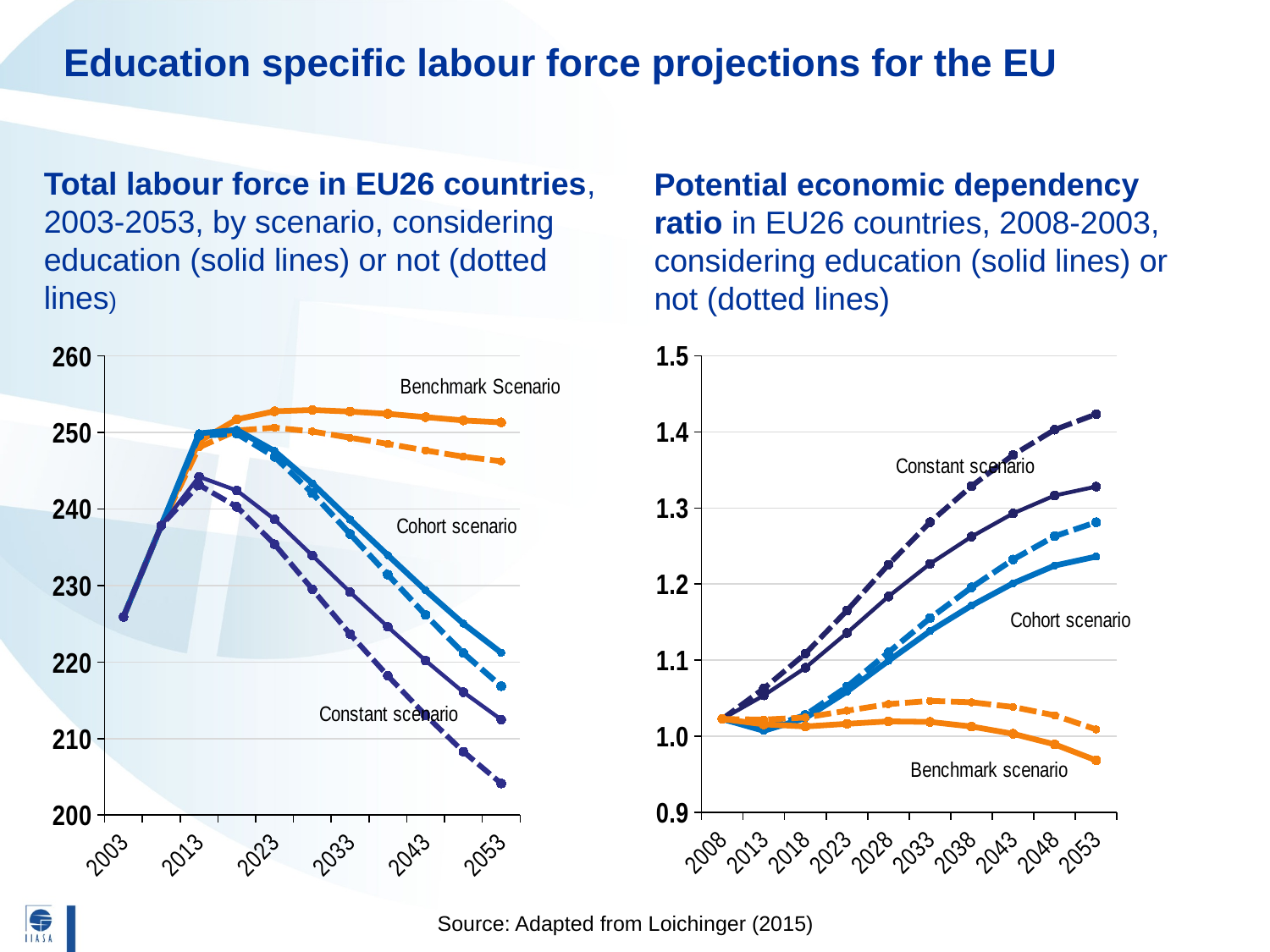
In the left chart (Total labour force), is the value of the solid Cohort scenario line in 2053 greater or less than 230? less In the right chart (Potential economic dependency ratio), which scenario has the highest value in 2053? Constant scenario How many scenarios are labelled on the left chart (Total labour force)? 3 In the left chart (Total labour force), which scenario has the highest value in 2053? Benchmark Scenario In the right chart (Potential economic dependency ratio), which scenario has the lowest value in 2053? Benchmark scenario What kind of chart is the right chart, 'Potential economic dependency ratio'? line chart In the left chart (Total labour force), which scenario has the lowest value in 2053? Constant scenario What kind of chart is the left chart, 'Total labour force in EU26 countries'? line chart In the right chart (Potential economic dependency ratio), which is larger in 2053: the Cohort scenario or the Benchmark scenario? Cohort scenario In the right chart (Potential economic dependency ratio), do the Constant scenario lines rise or fall from 2008 to 2053? rise In the left chart (Total labour force), is the value of the dotted Constant scenario line in 2053 greater or less than 210? less In the right chart (Potential economic dependency ratio), is the value of the solid Benchmark scenario line in 2053 greater or less than 1.0? less